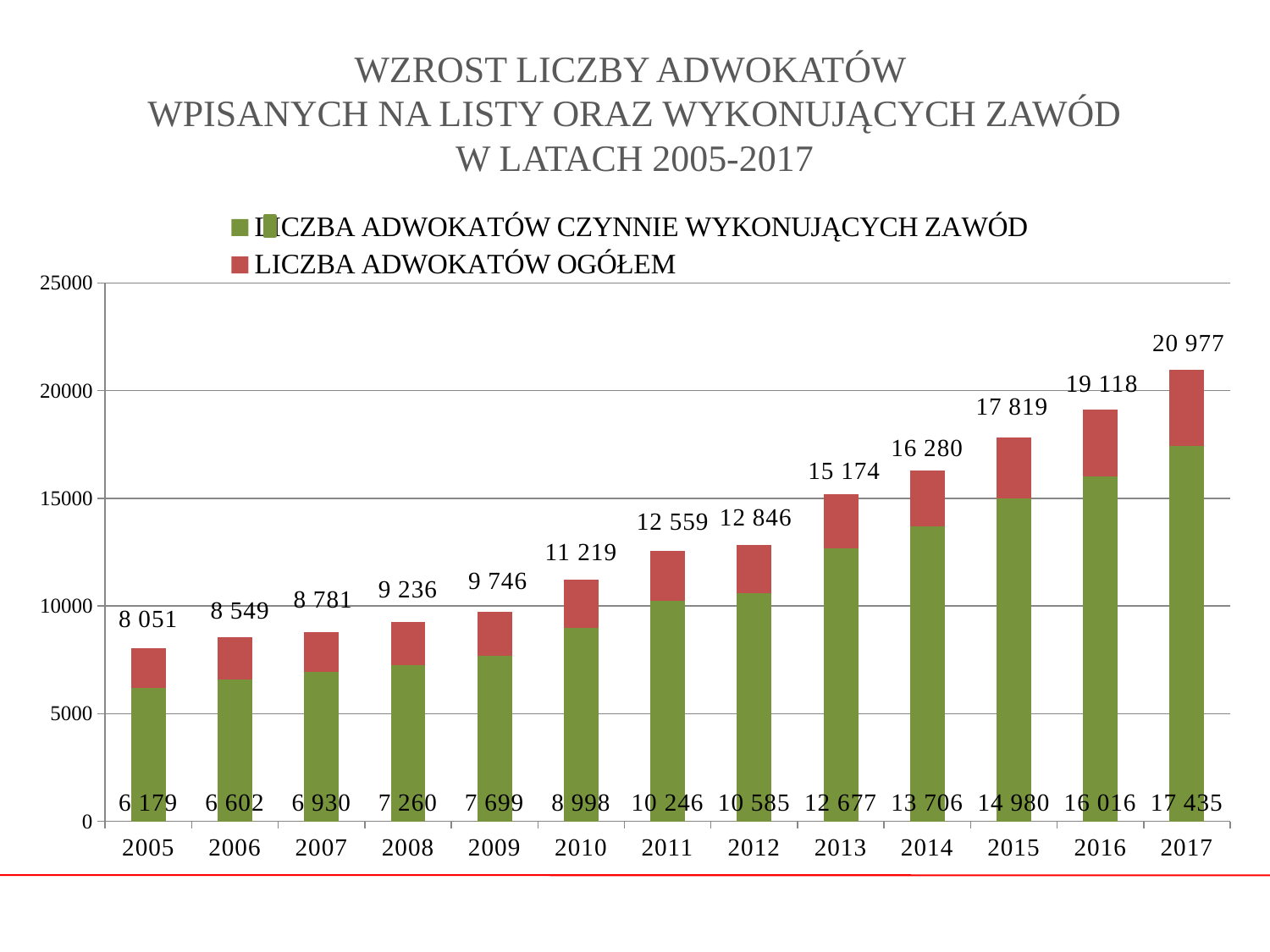
By how much did LICZBA ADWOKATÓW OGÓŁEM increase from 2005 to 2017? 12 926 How many years are shown on the x axis of the chart? 13 Which year has the highest value of LICZBA ADWOKATÓW OGÓŁEM? 2017 What kind of chart is shown on the slide? Bar chart What is the value of LICZBA ADWOKATÓW OGÓŁEM for 2017? 20 977 What is the difference between LICZBA ADWOKATÓW OGÓŁEM and LICZBA ADWOKATÓW CZYNNIE WYKONUJĄCYCH ZAWÓD in 2017? 3 542 How many series does the legend list? 2 Do the values of LICZBA ADWOKATÓW OGÓŁEM rise or fall from 2005 to 2017? Rise What is the value of LICZBA ADWOKATÓW CZYNNIE WYKONUJĄCYCH ZAWÓD for 2010? 8 998 What is the value of LICZBA ADWOKATÓW OGÓŁEM for 2013? 15 174 Which is larger: LICZBA ADWOKATÓW CZYNNIE WYKONUJĄCYCH ZAWÓD in 2015 or LICZBA ADWOKATÓW OGÓŁEM in 2012? LICZBA ADWOKATÓW CZYNNIE WYKONUJĄCYCH ZAWÓD in 2015 Which year has the lowest value of LICZBA ADWOKATÓW CZYNNIE WYKONUJĄCYCH ZAWÓD? 2005